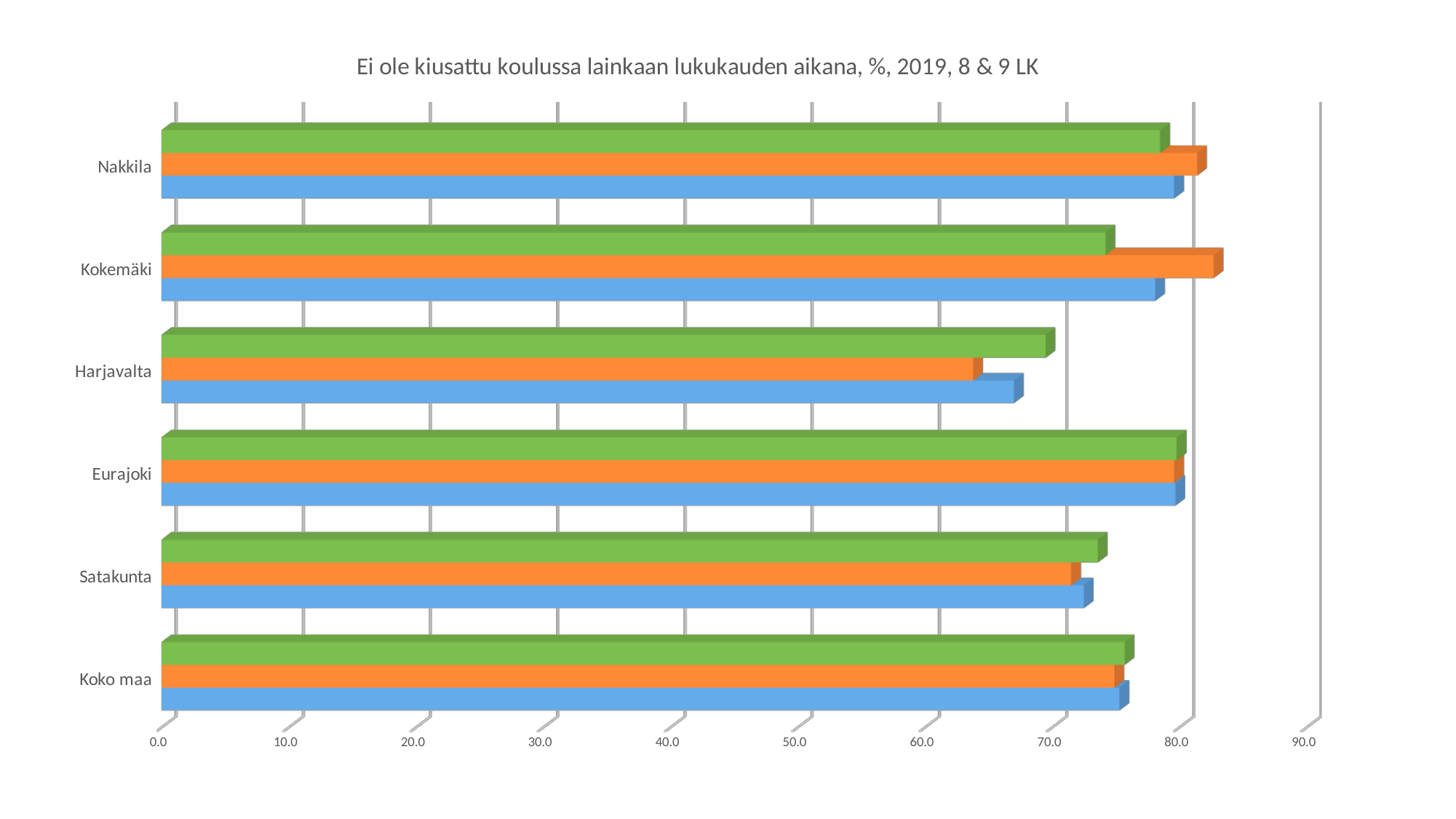
Is the orange bar for Kokemäki greater or less than 80? greater Is the blue bar for Satakunta greater or less than 70? greater What kind of chart is shown on the slide? bar chart For Harjavalta, which bar is longer, the green bar or the orange bar? green Which category has the lowest orange bar? Harjavalta Is the green bar for Koko maa greater or less than 80? less How many categories are shown on the vertical axis of the chart? 6 Which category has the highest orange bar? Kokemäki How many bars are plotted for each category in the chart? 3 For Kokemäki, which bar is longer, the orange bar or the green bar? orange What is the title of the chart? Ei ole kiusattu koulussa lainkaan lukukauden aikana, %, 2019, 8 & 9 LK